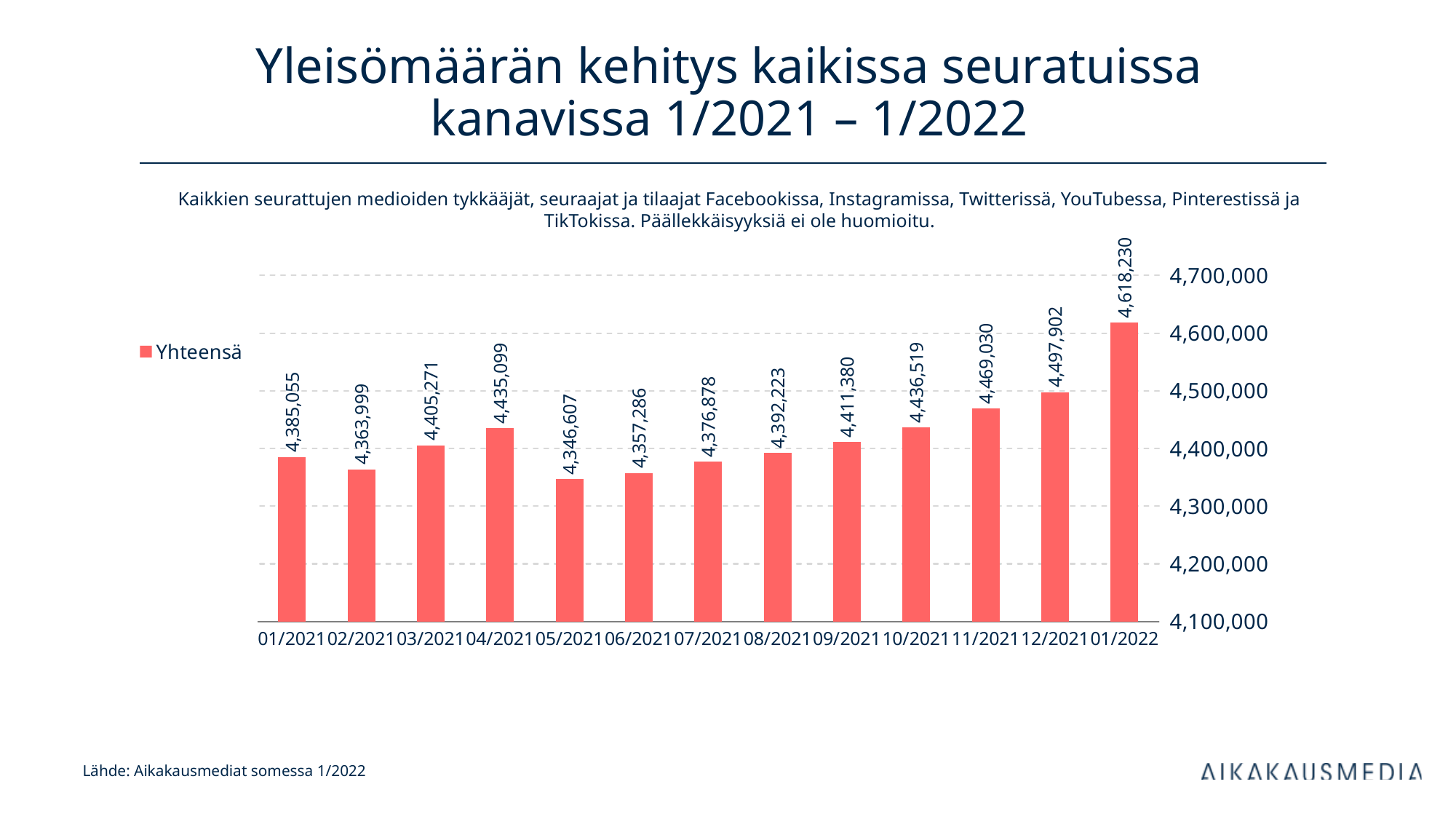
Is the value for 12/2021 greater or less than 4,500,000? less Which month has the lowest value? 05/2021 What is the value for 05/2021? 4,346,607 What is the value for 09/2021? 4,411,380 What is the difference between the values for 01/2022 and 01/2021? 233,175 How many months are shown on the x axis? 13 What kind of chart is shown on the slide? bar chart Which is larger, the value for 03/2021 or the value for 07/2021? 03/2021 What is the value for 01/2022? 4,618,230 What is the difference between the values for 04/2021 and 05/2021? 88,492 What series name does the legend show? Yhteensä Which month has the highest value? 01/2022